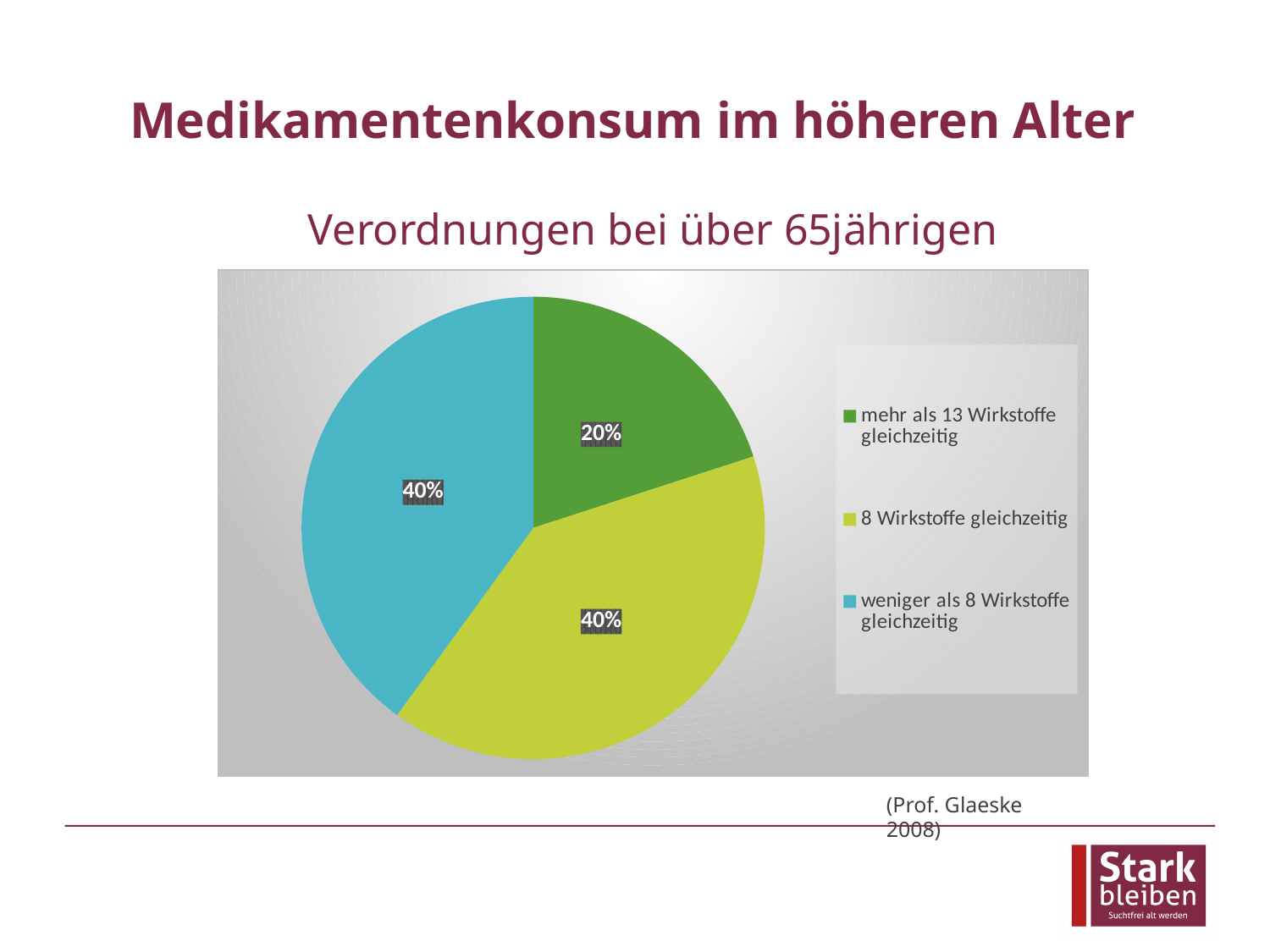
What is the combined share of the two 40% slices? 80% What is the title of the chart? Verordnungen bei über 65jährigen What share of the pie is labelled "8 Wirkstoffe gleichzeitig"? 40% What kind of chart is shown on the slide? pie chart How many entries does the legend list? 3 Which is larger: the slice for "8 Wirkstoffe gleichzeitig" or the slice for "mehr als 13 Wirkstoffe gleichzeitig"? 8 Wirkstoffe gleichzeitig By how many percentage points is the "weniger als 8 Wirkstoffe gleichzeitig" slice larger than the "mehr als 13 Wirkstoffe gleichzeitig" slice? 20 percentage points Which category is shown in the blue (cyan) colour? weniger als 8 Wirkstoffe gleichzeitig How many slices does the pie chart have? 3 Which category has the smallest slice of the pie? mehr als 13 Wirkstoffe gleichzeitig What share of the pie is labelled "weniger als 8 Wirkstoffe gleichzeitig"? 40% What share of the pie is labelled "mehr als 13 Wirkstoffe gleichzeitig"? 20%